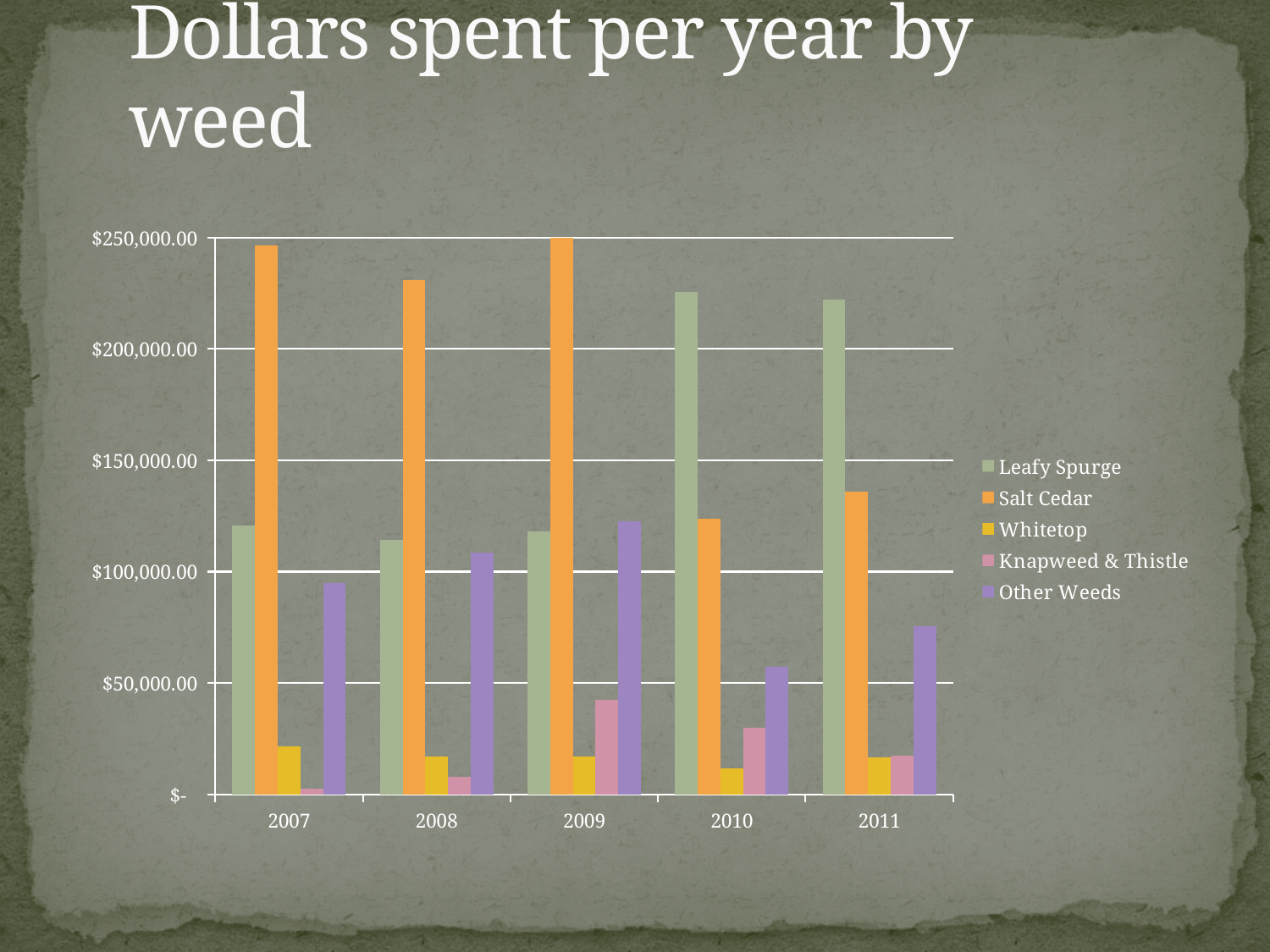
Which weed had the lowest spending in 2007? Knapweed & Thistle What kind of chart is shown on the slide? bar chart Is the value for Salt Cedar in 2007 greater or less than $200,000.00? greater What is the title of the chart? Dollars spent per year by weed Does spending on Salt Cedar rise or fall from 2009 to 2011? fall In 2009, which is larger: the value for Salt Cedar or the value for Leafy Spurge? Salt Cedar Is the value for Other Weeds in 2011 greater or less than $100,000.00? less Is the value for Leafy Spurge in 2010 greater or less than $200,000.00? greater Which weed had the highest spending in 2008? Salt Cedar How many series does the legend list? 5 In 2010, which is larger: the value for Leafy Spurge or the value for Salt Cedar? Leafy Spurge How many years are shown on the x axis? 5